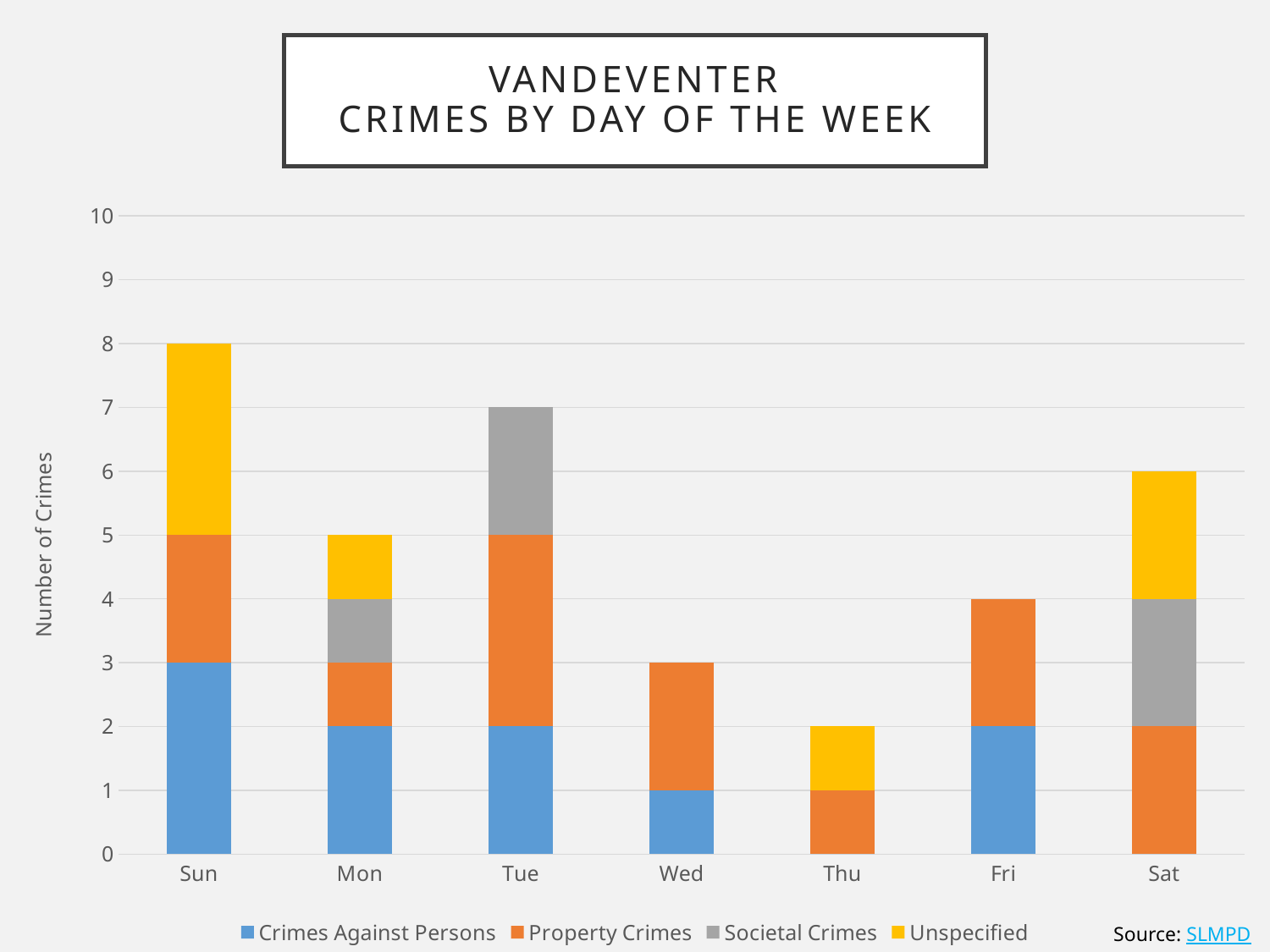
What is the title of the chart? Vandeventer Crimes by Day of the Week How many Property Crimes were recorded on Tue? 3 Which day has the highest total number of crimes? Sun What is the total number of crimes on Tue? 7 What is the total number of crimes on Sat? 6 What kind of chart is shown on the slide? Stacked bar chart How many days of the week are shown on the x axis? 7 Which day has the lowest total number of crimes? Thu What is the difference between the total crimes on Sun and the total crimes on Thu? 6 How many series does the legend list? 4 Which day has a higher total number of crimes, Tue or Sat? Tue How many Crimes Against Persons were recorded on Sun? 3